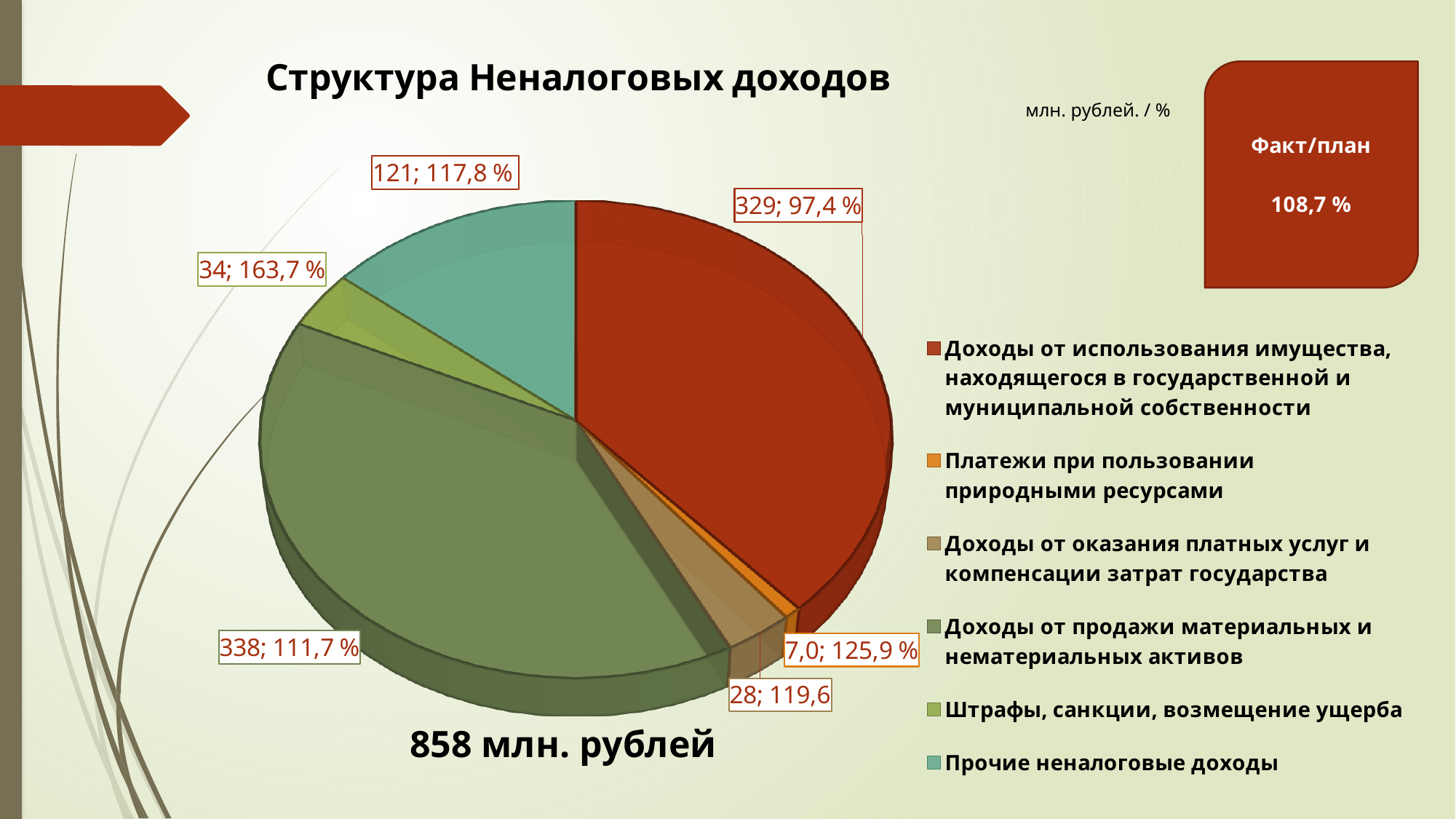
What is the title of the chart? Структура Неналоговых доходов Which is larger: the value for Прочие неналоговые доходы or the value for Штрафы, санкции, возмещение ущерба? Прочие неналоговые доходы What is the value (млн. рублей) for Доходы от продажи материальных и нематериальных активов? 338 What is the value (млн. рублей) for Штрафы, санкции, возмещение ущерба? 34 What total amount is shown below the pie chart? 858 млн. рублей What is the difference in млн. рублей between Доходы от продажи материальных и нематериальных активов (338) and Доходы от использования имущества (329)? 9 Which category has the largest value in the pie chart? Доходы от продажи материальных и нематериальных активов What percentage of plan is shown for Прочие неналоговые доходы? 117,8 % Which category has the smallest value in the pie chart? Платежи при пользовании природными ресурсами How many slices does the pie chart have? 6 What kind of chart is shown on the slide? pie chart What is the value (млн. рублей) for Платежи при пользовании природными ресурсами? 7,0